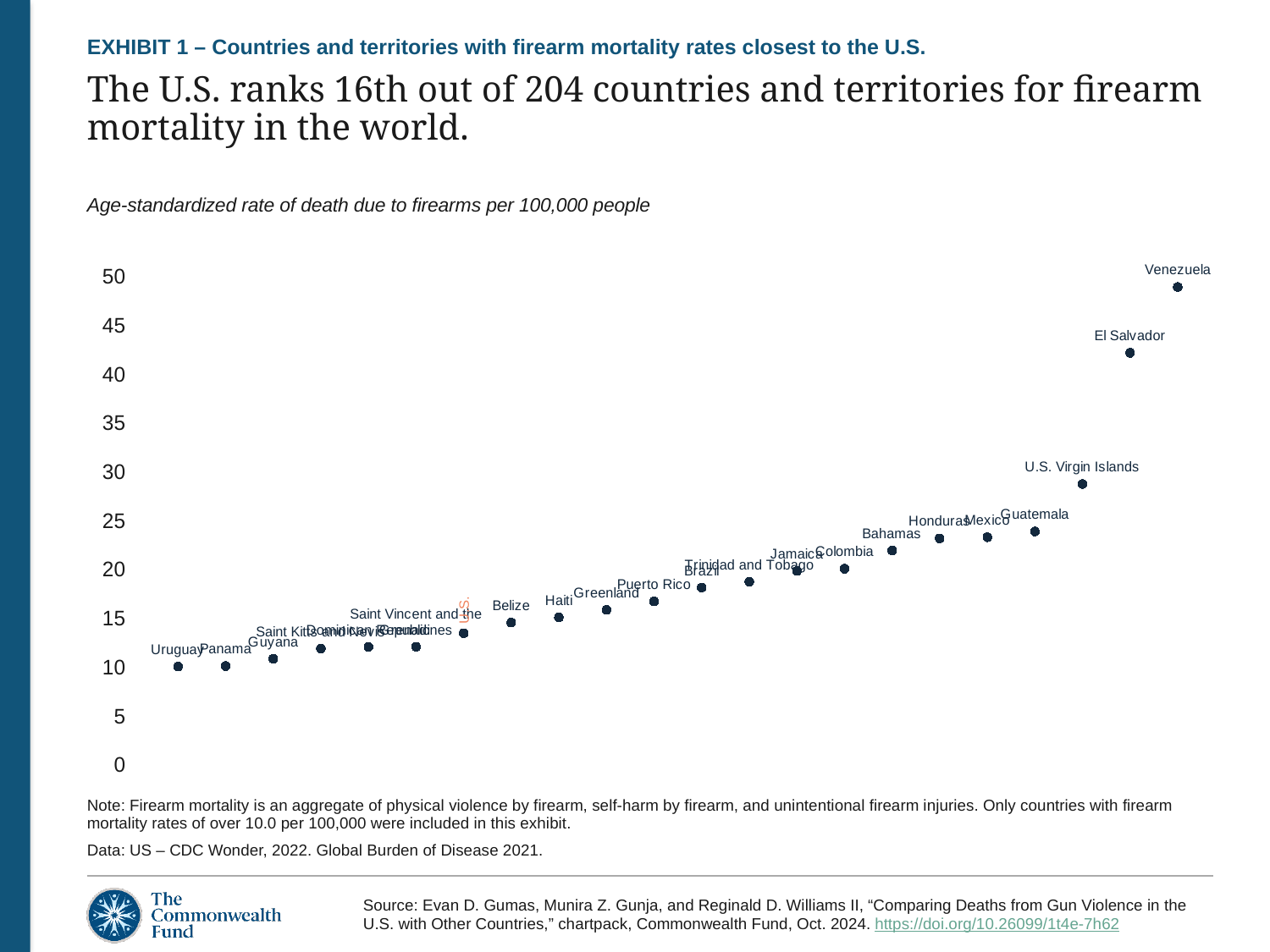
Which country or territory has the highest firearm mortality rate on the chart? Venezuela Is the value for El Salvador greater or less than 40? greater Which has a higher firearm mortality rate, U.S. Virgin Islands or Guatemala? U.S. Virgin Islands Which has a higher firearm mortality rate, Venezuela or El Salvador? Venezuela What measure does the chart plot, according to the subtitle above it? Age-standardized rate of death due to firearms per 100,000 people Is the value for Haiti greater or less than 20? less Is the value for Venezuela greater or less than 45? greater What kind of chart is shown on the slide? scatter (dot) chart Do the plotted values rise or fall moving from left to right along the chart? rise